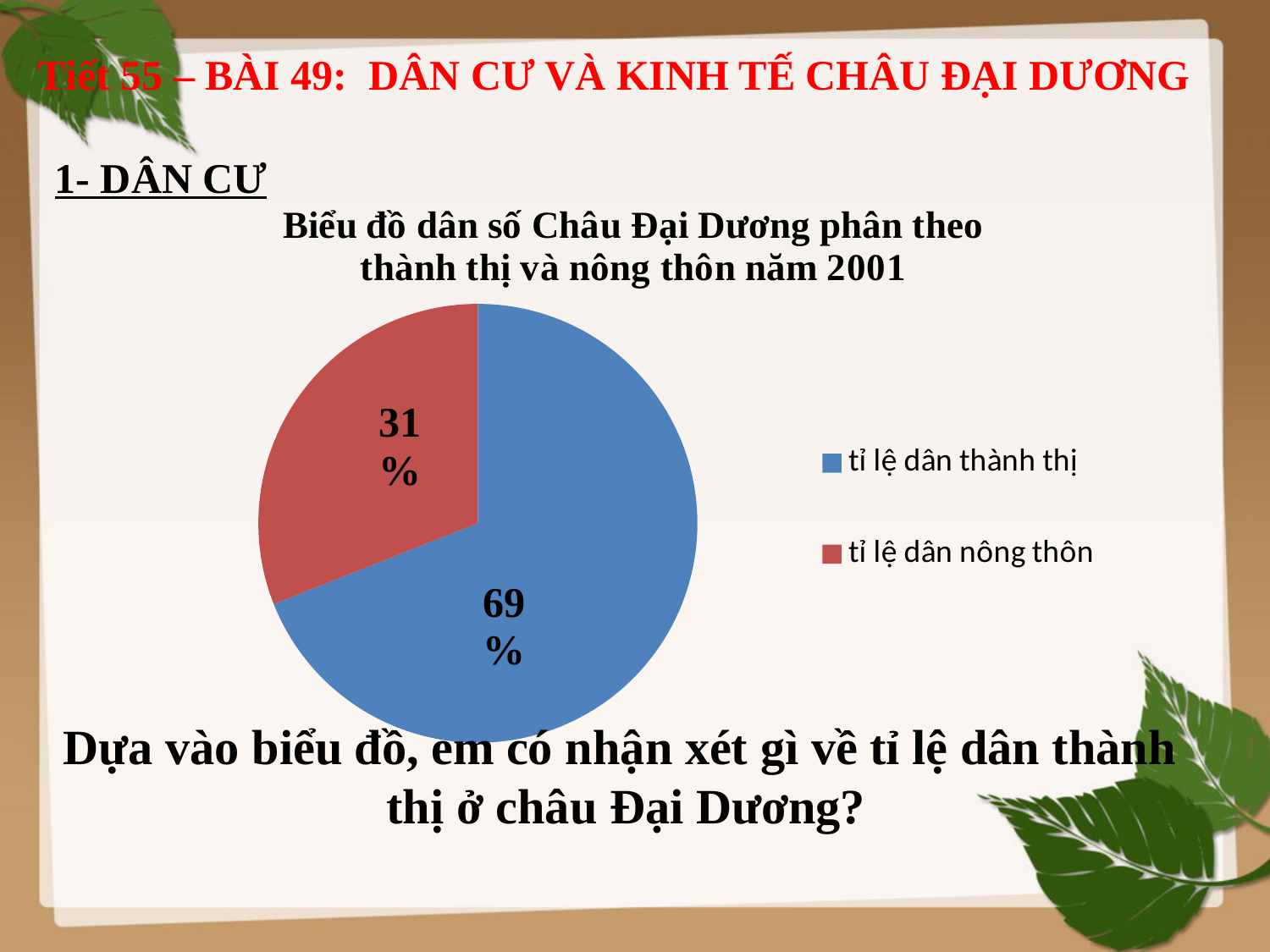
Which category has the largest slice of the pie chart? tỉ lệ dân thành thị What is the title of the chart on the slide? Biểu đồ dân số Châu Đại Dương phân theo thành thị và nông thôn năm 2001 What is the difference in percentage points between the urban share and the rural share in the pie chart? 38 What percentage of the pie chart is labelled for 'tỉ lệ dân nông thôn'? 31% How many slices does the pie chart have? 2 What kind of chart is shown on the slide? pie chart Which category has the smallest slice of the pie chart? tỉ lệ dân nông thôn Which is larger in the pie chart: 'tỉ lệ dân thành thị' or 'tỉ lệ dân nông thôn'? tỉ lệ dân thành thị What colour is the slice for 'tỉ lệ dân nông thôn' in the pie chart? red What share of the pie does the 'tỉ lệ dân nông thôn' slice represent? 31% How many entries does the legend of the chart list? 2 What percentage of the pie chart is labelled for 'tỉ lệ dân thành thị'? 69%